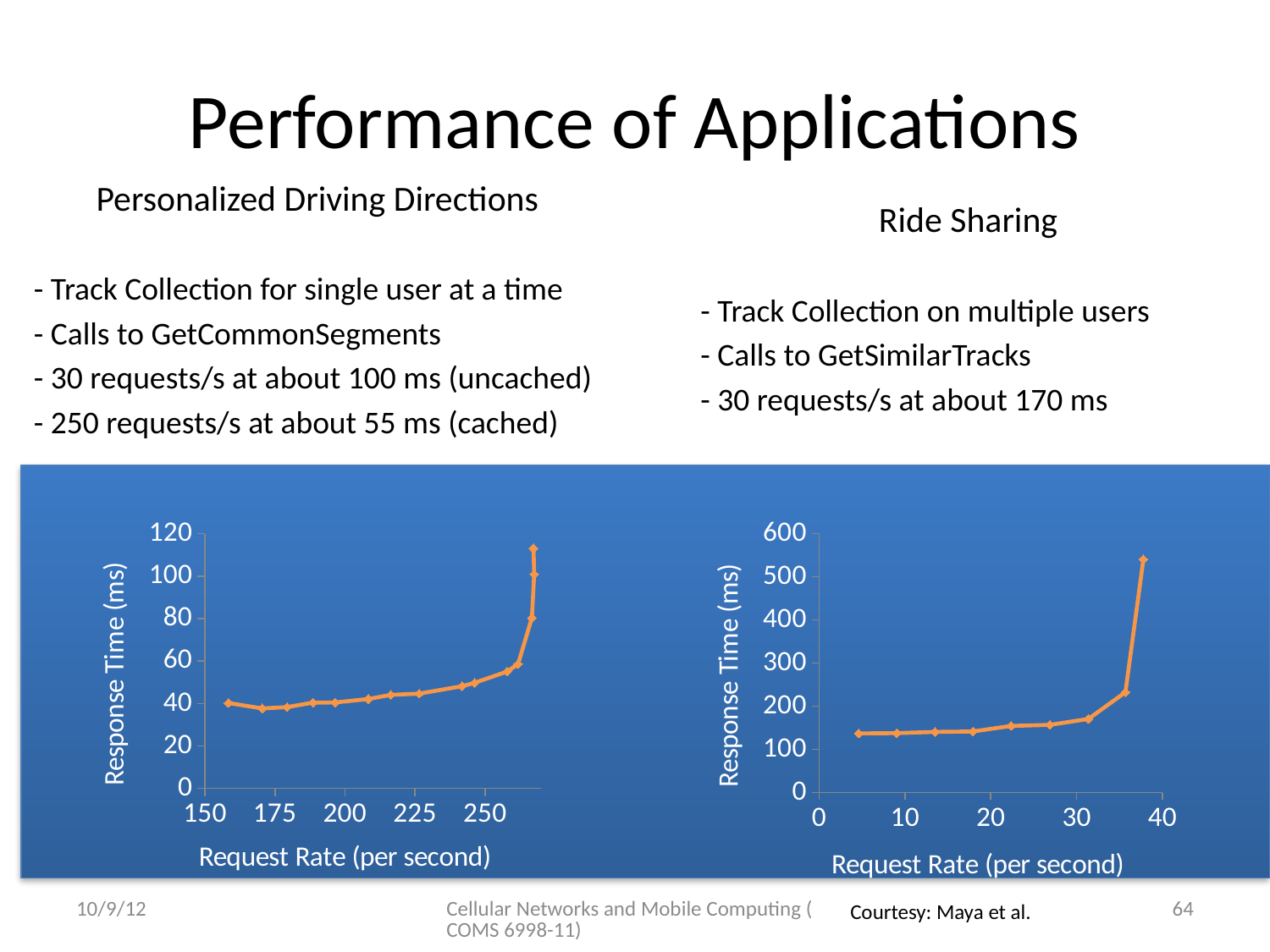
What is the y-axis label of the Personalized Driving Directions chart on the left? Response Time (ms) What kind of chart is the Ride Sharing chart on the right? line chart In the Ride Sharing chart on the right, is the highest plotted response time greater or less than 500 ms? greater What kind of chart is the Personalized Driving Directions chart on the left? line chart What is the x-axis label of the Ride Sharing chart on the right? Request Rate (per second) In the Personalized Driving Directions chart on the left, is the response time at a request rate of 250 per second higher or lower than at 175 per second? higher In the Personalized Driving Directions chart on the left, is the highest plotted response time greater or less than 100 ms? greater In the Personalized Driving Directions chart on the left, is the response time at a request rate of 225 per second greater or less than 60 ms? less In the Ride Sharing chart on the right, is the response time at a request rate of 30 per second higher or lower than at 10 per second? higher In the Personalized Driving Directions chart on the left, does the response time rise or fall as the request rate increases toward the right end of the x axis? rise In the Ride Sharing chart on the right, does the response time rise or fall as the request rate increases? rise